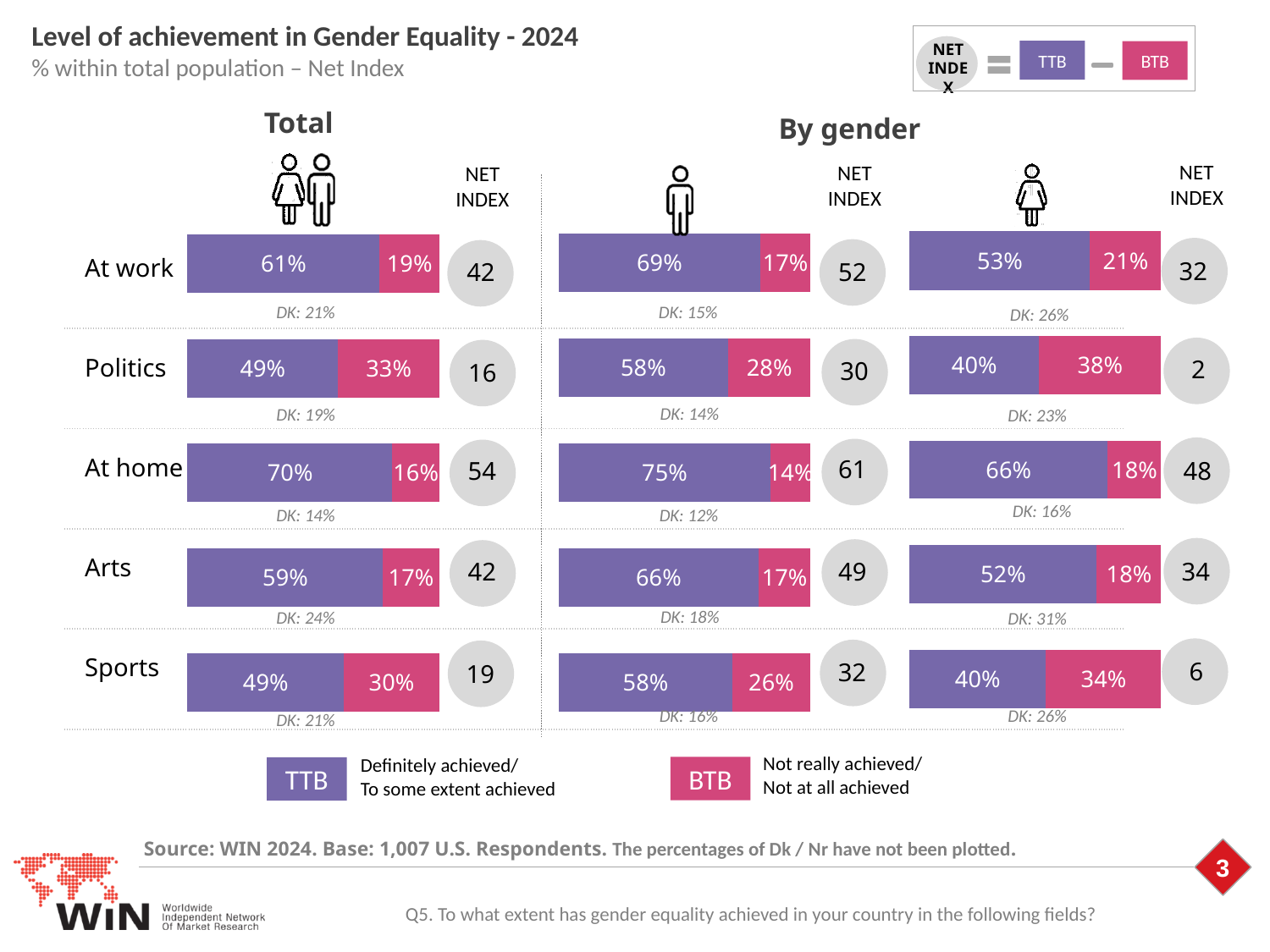
How many categories are shown in the Total chart? 5 In the Total chart, what is the combined TTB and BTB total for Sports? 79% In the men's chart under By gender, what is the difference between the TTB values for At home and Sports? 17 percentage points In the Total chart, which category has the highest Net Index? At home In the women's chart under By gender, what is the Net Index for Politics? 2 In the Total chart, what is the Net Index for At home? 54 In the men's chart under By gender, what is the BTB value for Politics? 28% In the Total chart, what is the TTB value for At work? 61% Which is larger: the Net Index for Arts in the men's chart or in the women's chart? Men's chart (49) In the women's chart under By gender, which category has the lowest TTB value? Politics and Sports (both 40%) What type of chart is used in the Total panel? Stacked horizontal bar chart How many series does the legend at the bottom of the slide list? 2